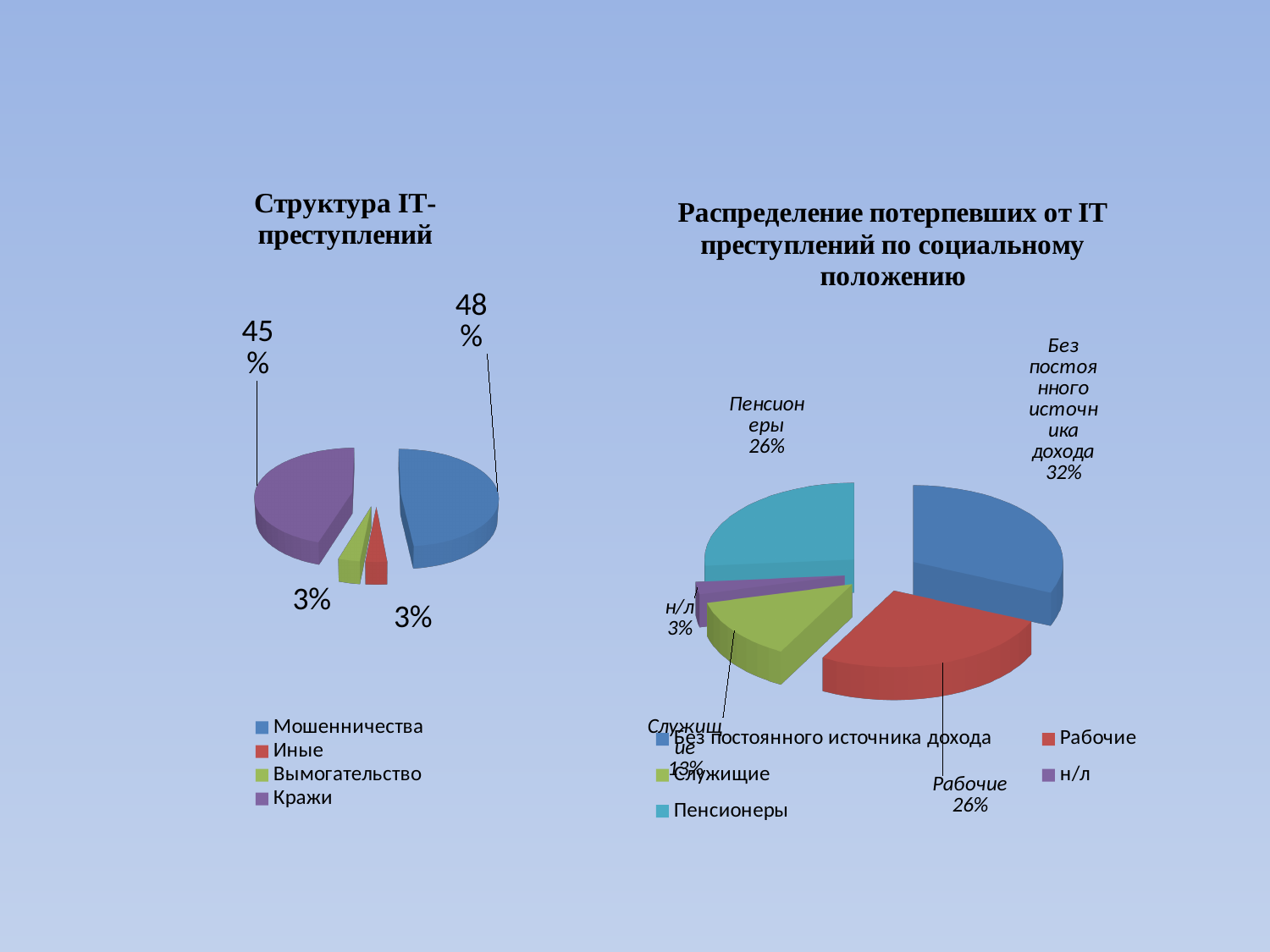
On the chart titled 'Распределение потерпевших от IT преступлений по социальному положению', which category has the smallest share? н/л On the chart titled 'Распределение потерпевших от IT преступлений по социальному положению', what share is Пенсионеры? 26% On the chart titled 'Структура IT-преступлений', how many categories does the legend list? 4 On the chart titled 'Распределение потерпевших от IT преступлений по социальному положению', which is larger: Без постоянного источника дохода or Рабочие? Без постоянного источника дохода What type of chart is the chart titled 'Структура IT-преступлений'? Pie chart On the chart titled 'Структура IT-преступлений', what share is Мошенничества? 48% On the chart titled 'Распределение потерпевших от IT преступлений по социальному положению', what share is Без постоянного источника дохода? 32% On the chart titled 'Структура IT-преступлений', what is the difference between the shares of Мошенничества and Кражи? 3% On the chart titled 'Распределение потерпевших от IT преступлений по социальному положению', how many categories does the legend list? 5 On the chart titled 'Структура IT-преступлений', what share is Кражи? 45% On the chart titled 'Структура IT-преступлений', which category has the largest share? Мошенничества On the chart titled 'Распределение потерпевших от IT преступлений по социальному положению', what is the difference between the shares of Рабочие and н/л? 23%